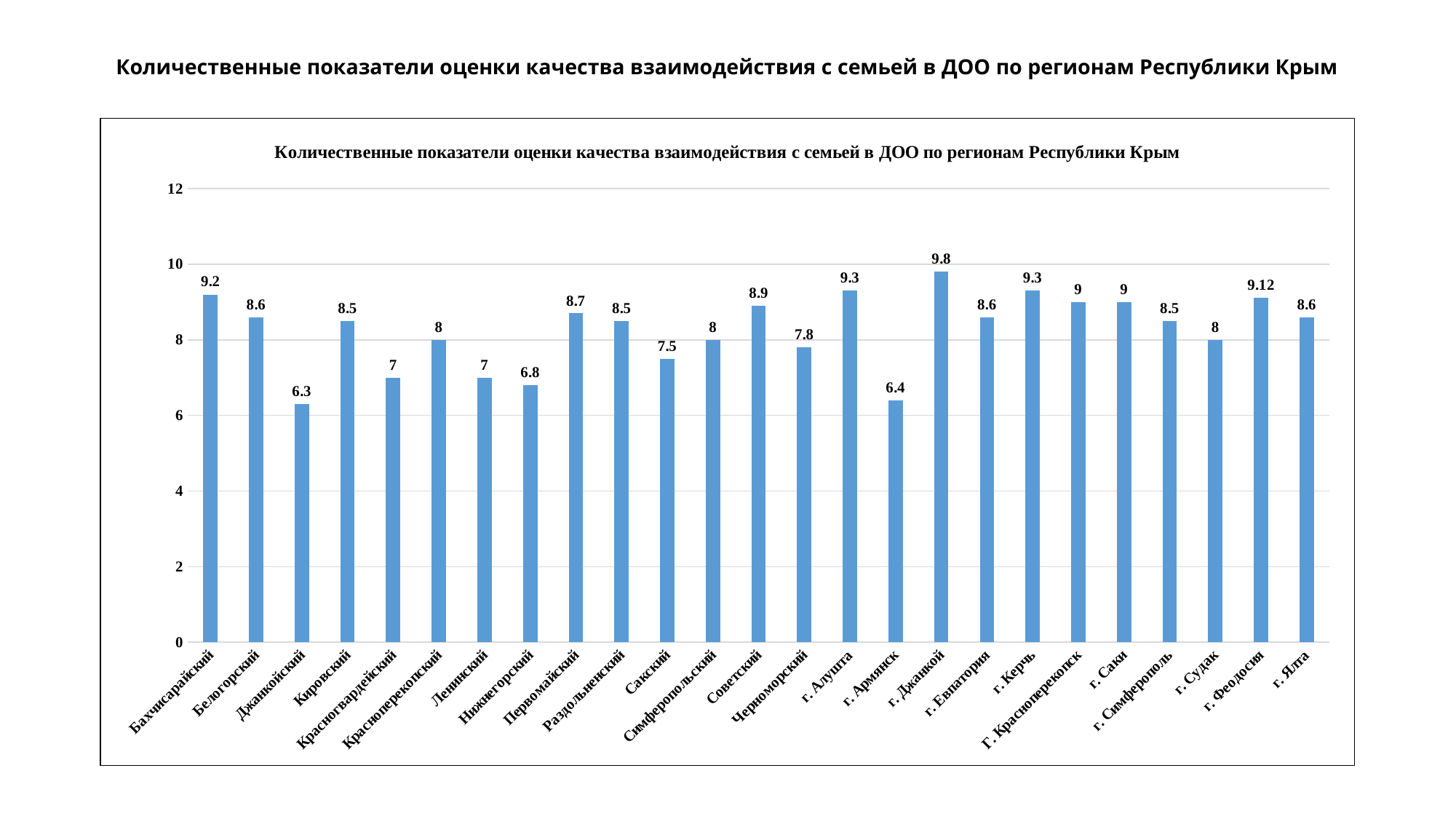
What is the value for Бахчисарайский? 9.2 Which is larger, the value for Советский or the value for Сакский? Советский What is the value for г. Феодосия? 9.12 What is the value for г. Армянск? 6.4 What kind of chart is shown on the slide? bar chart What is the difference between the values for г. Алушта and Черноморский? 1.5 Which region has the lowest value? Джанкойский Is the value for Красногвардейский greater or less than 8? less What is the difference between the values for г. Джанкой and Джанкойский? 3.5 How many regions are shown on the chart? 25 What is the value for Нижнегорский? 6.8 Which region has the highest value? г. Джанкой